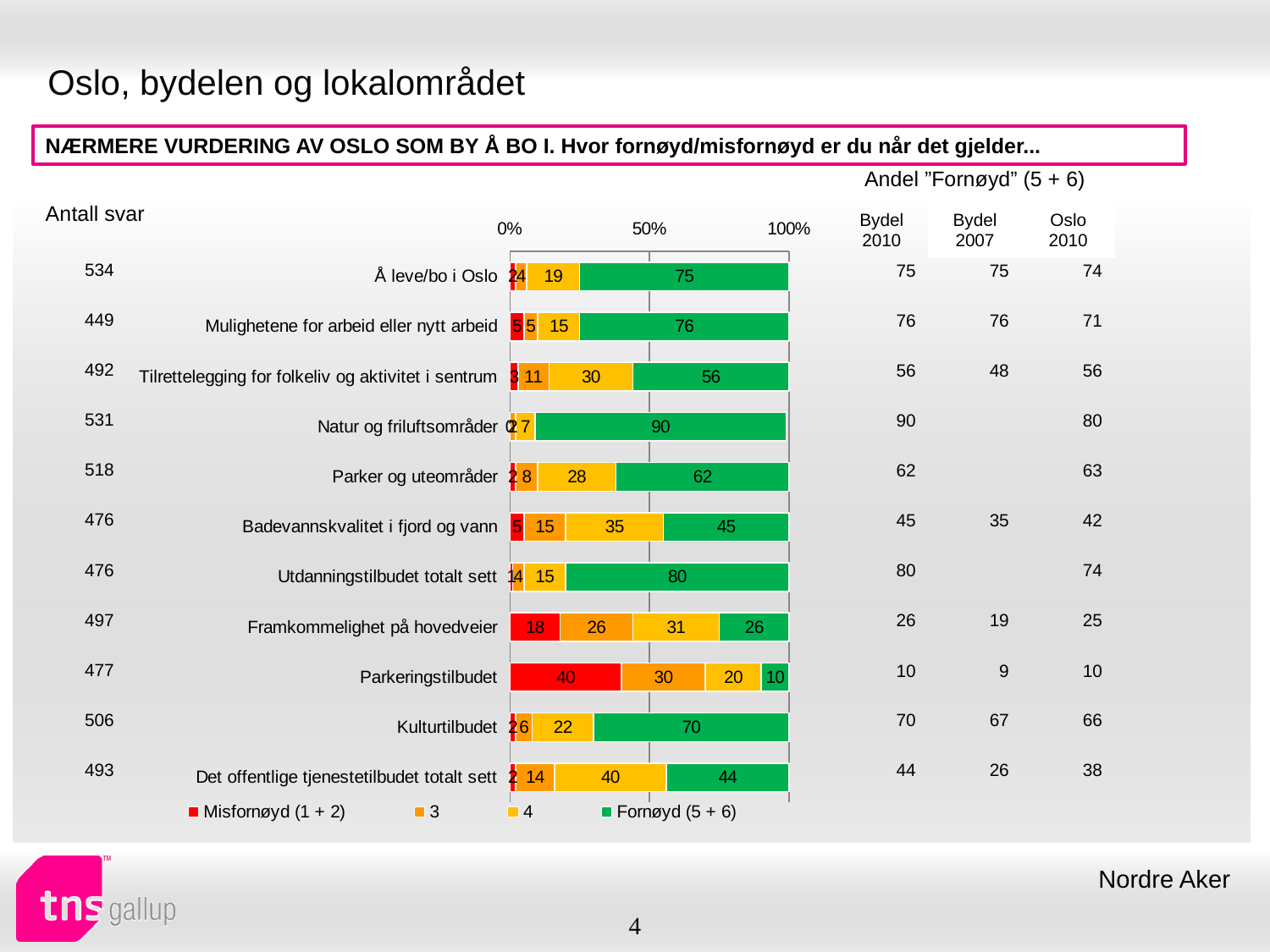
Which has a larger Fornøyd (5 + 6) value: Parker og uteområder or Tilrettelegging for folkeliv og aktivitet i sentrum? Parker og uteområder What is the total of the stacked bar for Parkeringstilbudet? 100 What is the difference between the Fornøyd (5 + 6) values for Utdanningstilbudet totalt sett and Kulturtilbudet? 10 What is the value of series 4 for Badevannskvalitet i fjord og vann? 35 What is the Misfornøyd (1 + 2) value for Parkeringstilbudet? 40 What is the Fornøyd (5 + 6) value for Natur og friluftsområder? 90 Which category has the lowest Fornøyd (5 + 6) value? Parkeringstilbudet What kind of chart is shown on the slide? Stacked bar chart How many series does the chart legend list? 4 Which category has the highest Fornøyd (5 + 6) value? Natur og friluftsområder Is the Fornøyd (5 + 6) value for Å leve/bo i Oslo greater or less than 50%? greater How many categories (rows) does the bar chart show? 11